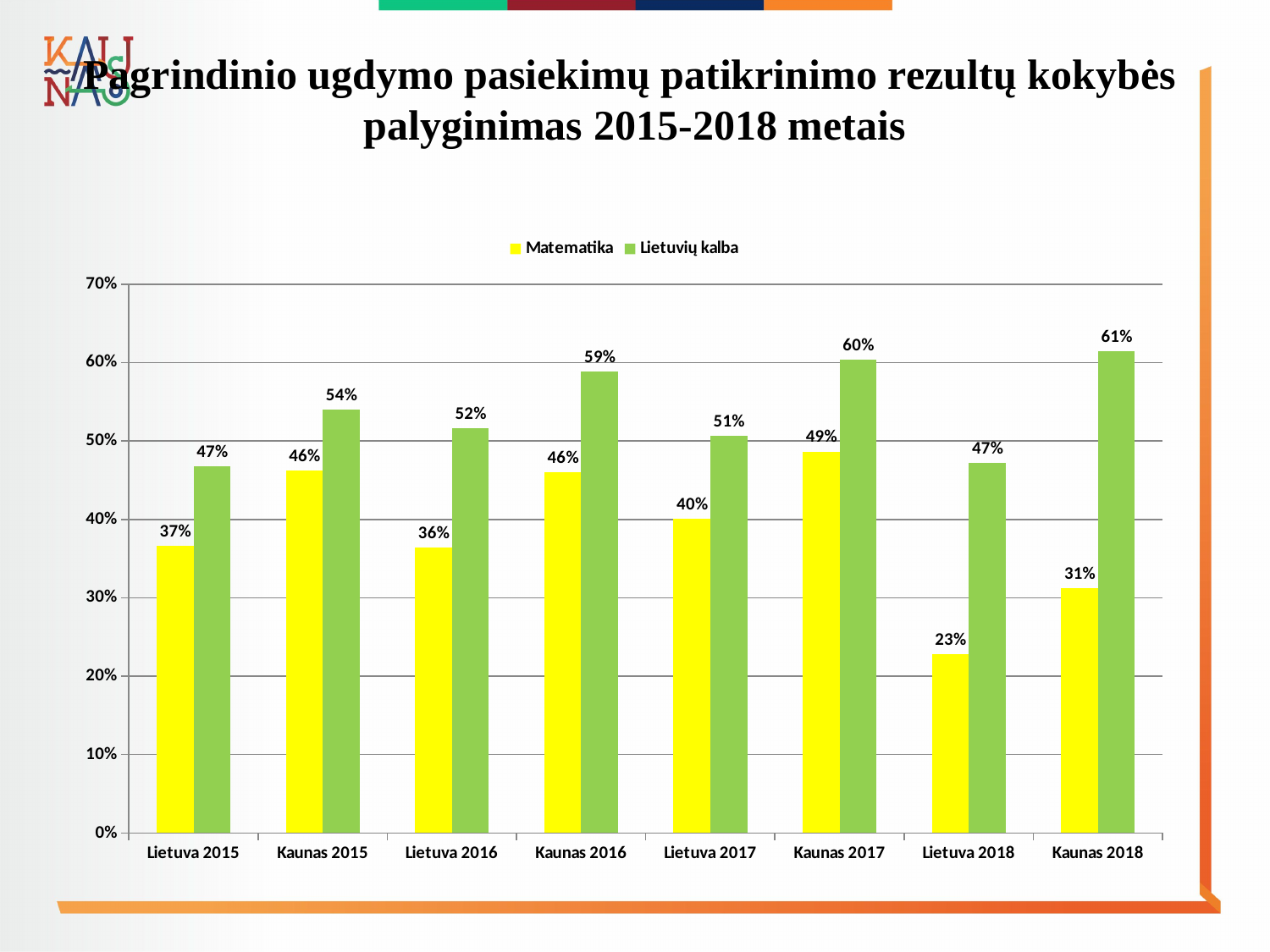
What is the Matematika value for Lietuva 2015? 37% How many series does the legend list? 2 Which is larger: the Matematika value for Kaunas 2015 or the Matematika value for Lietuva 2017? Kaunas 2015 What is the Matematika value for Lietuva 2018? 23% What is the Lietuvių kalba value for Kaunas 2018? 61% What kind of chart is shown on the slide? Bar chart Which category has the highest Lietuvių kalba value? Kaunas 2018 Which category has the lowest Matematika value? Lietuva 2018 What is the difference between the Lietuvių kalba and Matematika values for Kaunas 2017? 11% What is the difference between the Matematika values for Kaunas 2017 and Lietuva 2018? 26% Which series is shown in yellow? Matematika How many categories are shown on the x axis? 8